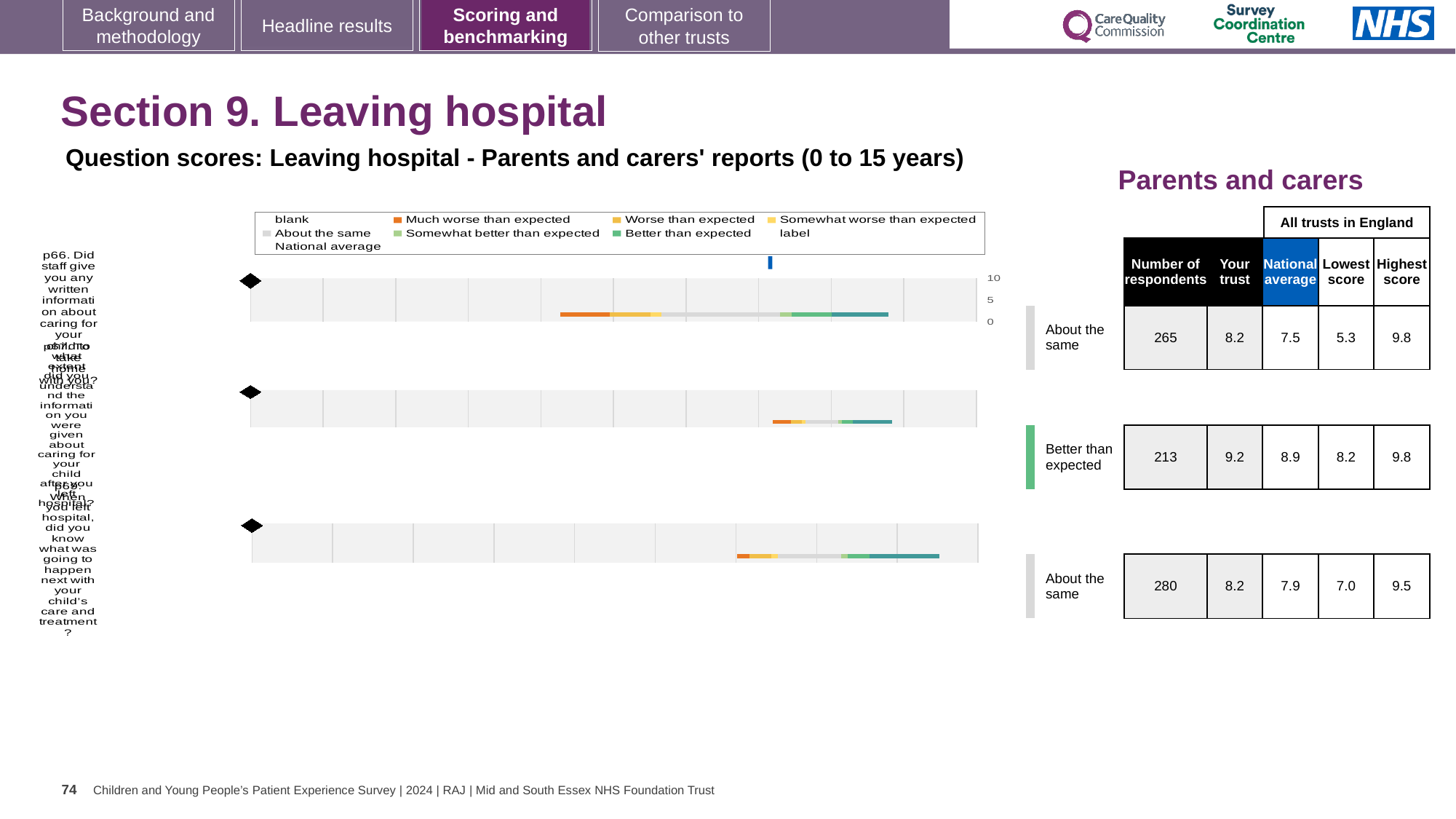
What kind of chart is used to show the question scores on this slide? bar chart What is the highest tick value shown on the chart axis? 10 Which row in the table has the highest 'Your trust' score? Better than expected How many question score charts (rows) are shown on the slide? 3 In the table, what is the lowest score for the first row? 5.3 In the table, what is the national average for the row labelled 'Better than expected'? 8.9 Which legend entry is shown in orange? Much worse than expected For the 'Better than expected' row, what is the difference between the 'Your trust' score and the national average? 0.3 In the table, what is the 'Your trust' score for the row labelled 'Better than expected'? 9.2 In the table, how many respondents are listed for the first row? 265 In the table, what is the highest score for the third row? 9.5 For the 'Better than expected' row, which is larger: the 'Your trust' score or the national average? Your trust